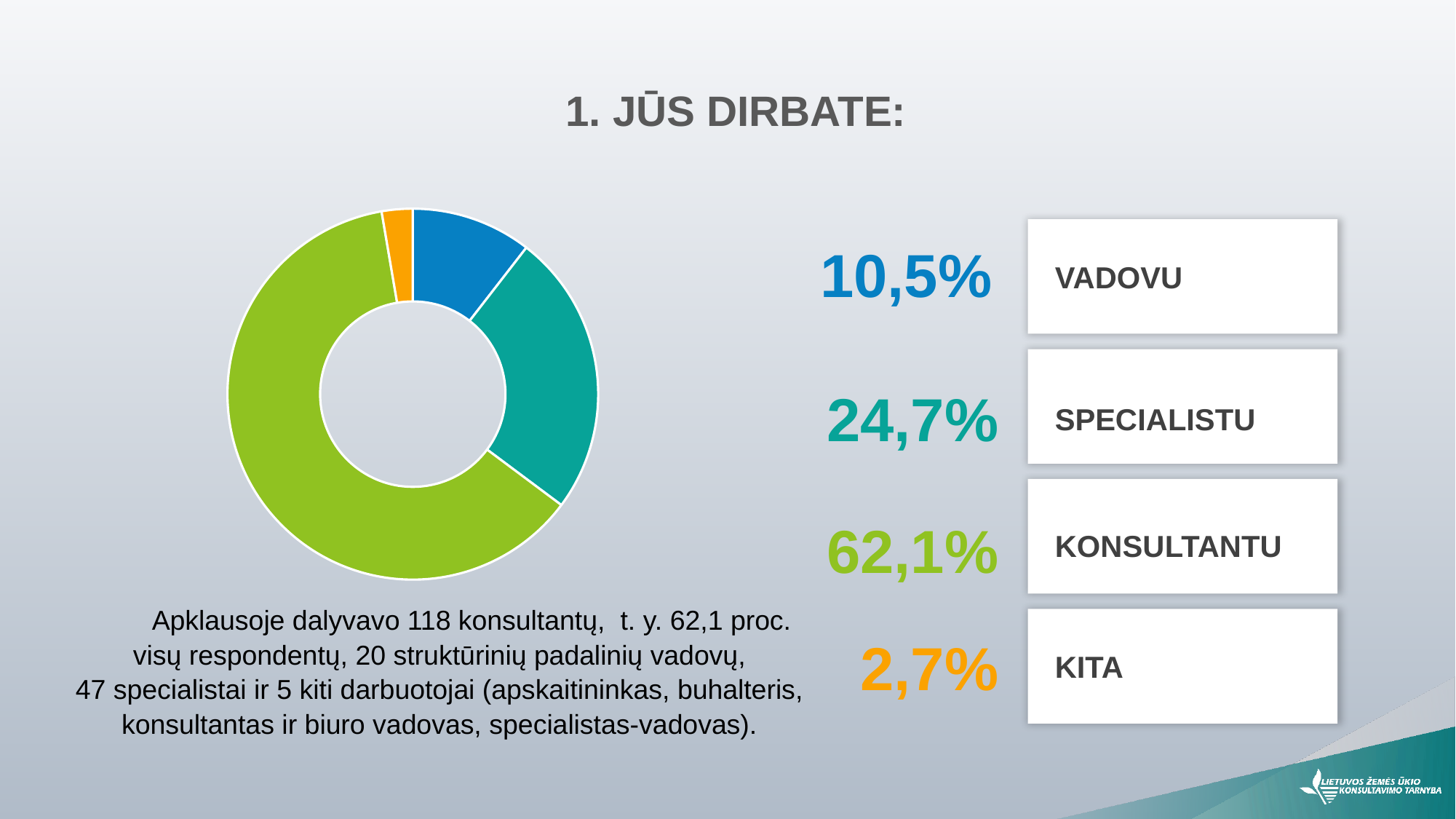
What is the difference between the VADOVU share and the KITA share? 7,8% What kind of chart is shown on the slide? Donut (pie) chart How many categories does the chart show? 4 Which is larger, the share for SPECIALISTU or the share for VADOVU? SPECIALISTU What colour represents the KONSULTANTU segment in the chart? Green What share of respondents work as VADOVU? 10,5% Which category has the largest share of the chart? KONSULTANTU What share of respondents work as KONSULTANTU? 62,1% Which category has the smallest share of the chart? KITA What is the difference between the KONSULTANTU share and the SPECIALISTU share? 37,4% What share of respondents work as SPECIALISTU? 24,7% What share of respondents fall under KITA? 2,7%